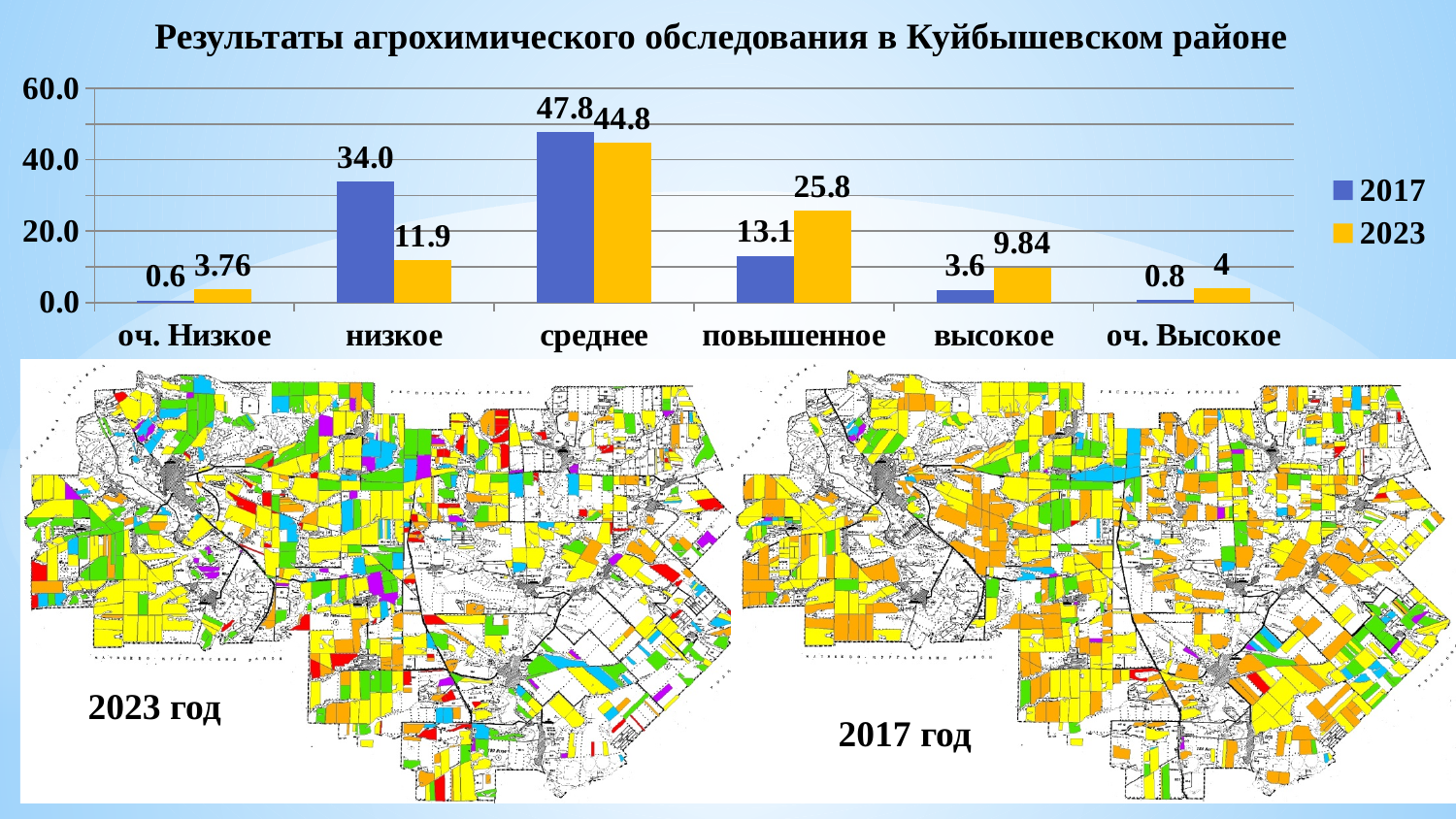
Which category has the lowest 2017 value? оч. Низкое What is the 2017 value for the category "низкое"? 34.0 What is the title of the chart? Результаты агрохимического обследования в Куйбышевском районе How many series does the legend of the chart list? 2 What is the difference between the 2017 and 2023 values for "низкое"? 22.1 What kind of chart is shown at the top of the slide? bar chart How many categories are shown on the x axis of the bar chart? 6 What is the 2023 value for the category "оч. Низкое"? 3.76 What is the 2017 value for the category "высокое"? 3.6 What is the 2023 value for the category "повышенное"? 25.8 Which category has the highest 2023 value? среднее Which is larger for "повышенное": the 2017 value or the 2023 value? 2023